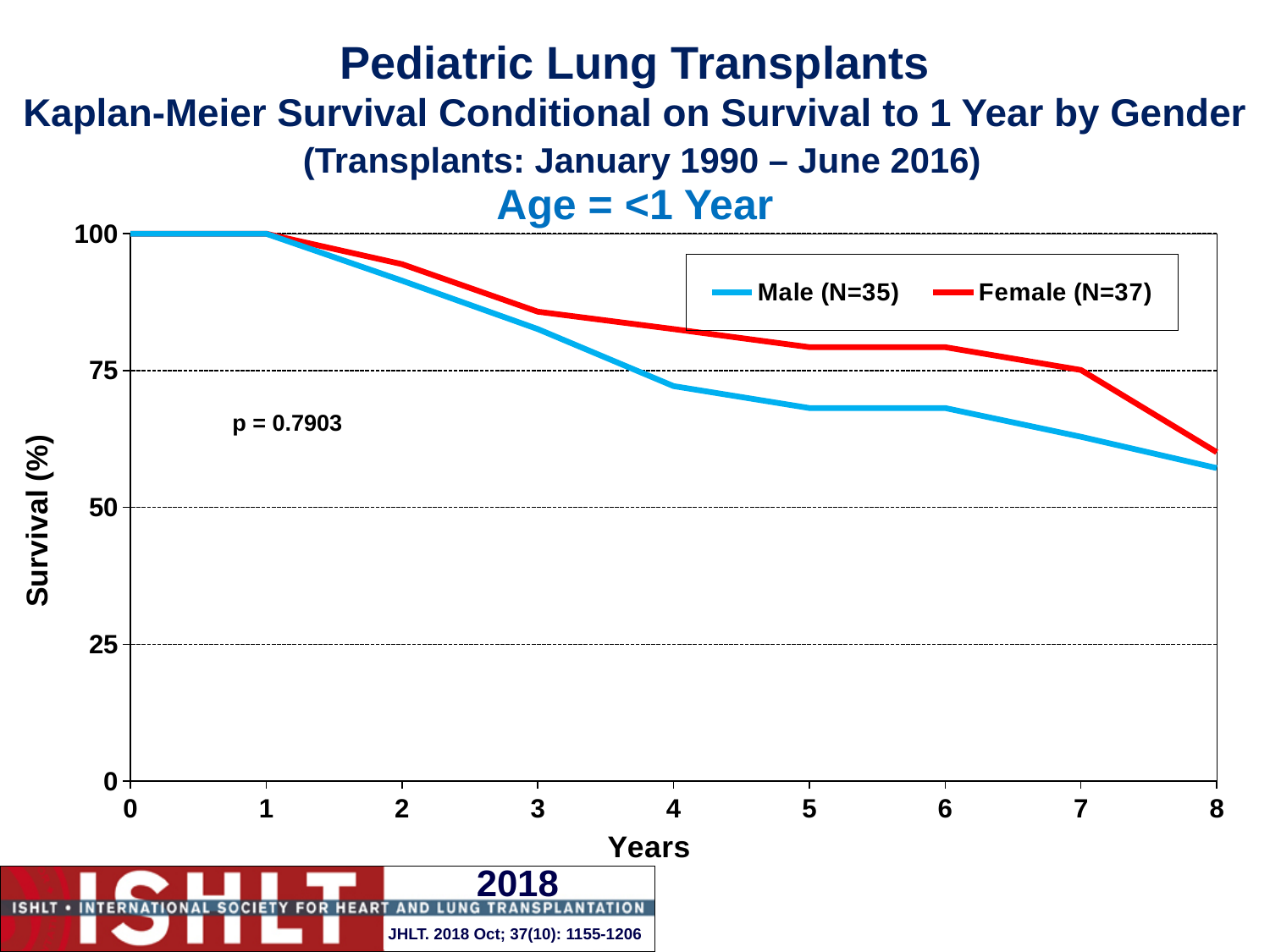
What is the N for the Female series in the legend? 37 Do the survival values for Male rise or fall as years increase? fall Is the survival value for Male at year 8 greater or less than 50? greater Is the survival value for Female at year 5 greater or less than 75? greater What kind of chart is shown on the slide? line chart What is the survival value for Female at year 0? 100 How many series does the legend list? 2 What is the survival value for Male at year 1? 100 Is the survival value for Male at year 5 greater or less than 75? less What p-value is printed on the chart? p = 0.7903 At year 6, which series has the higher survival, Male or Female? Female